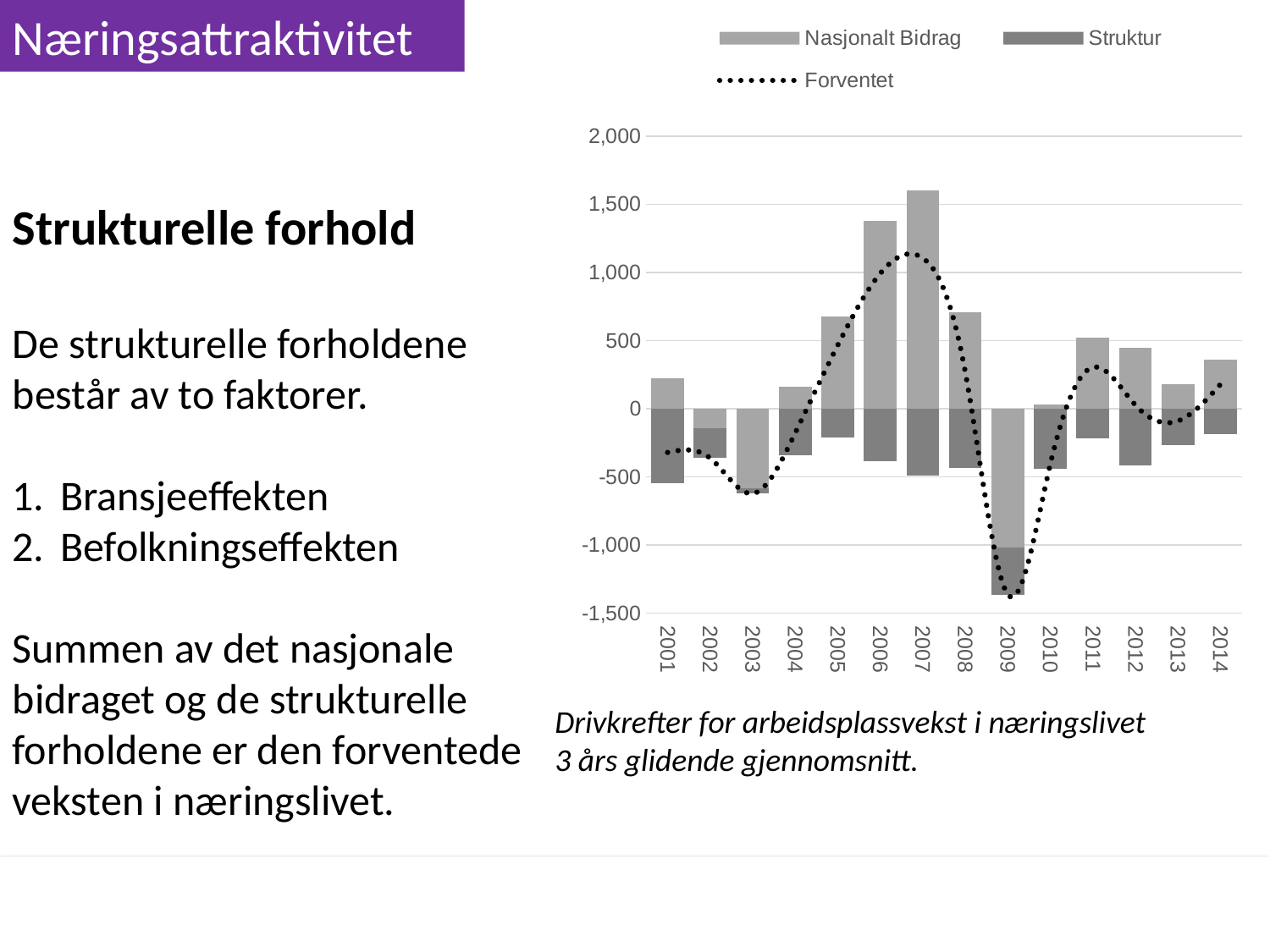
Is the Forventet value for 2009 greater or less than -1,000? less Which year has the larger Nasjonalt Bidrag value, 2006 or 2007? 2007 How many series does the chart legend list? 3 What kind of chart is used for the Nasjonalt Bidrag and Struktur series? Stacked bar chart How many years are shown on the x axis of the chart? 14 Is the Struktur value for 2005 greater or less than -500? greater Does the Forventet line rise or fall from 2004 to 2007? rise Which series is drawn as a dotted line in the chart? Forventet In which year is the Nasjonalt Bidrag bar highest? 2007 Is the Nasjonalt Bidrag value for 2006 greater or less than 1,000? greater In which year is the Nasjonalt Bidrag bar lowest? 2009